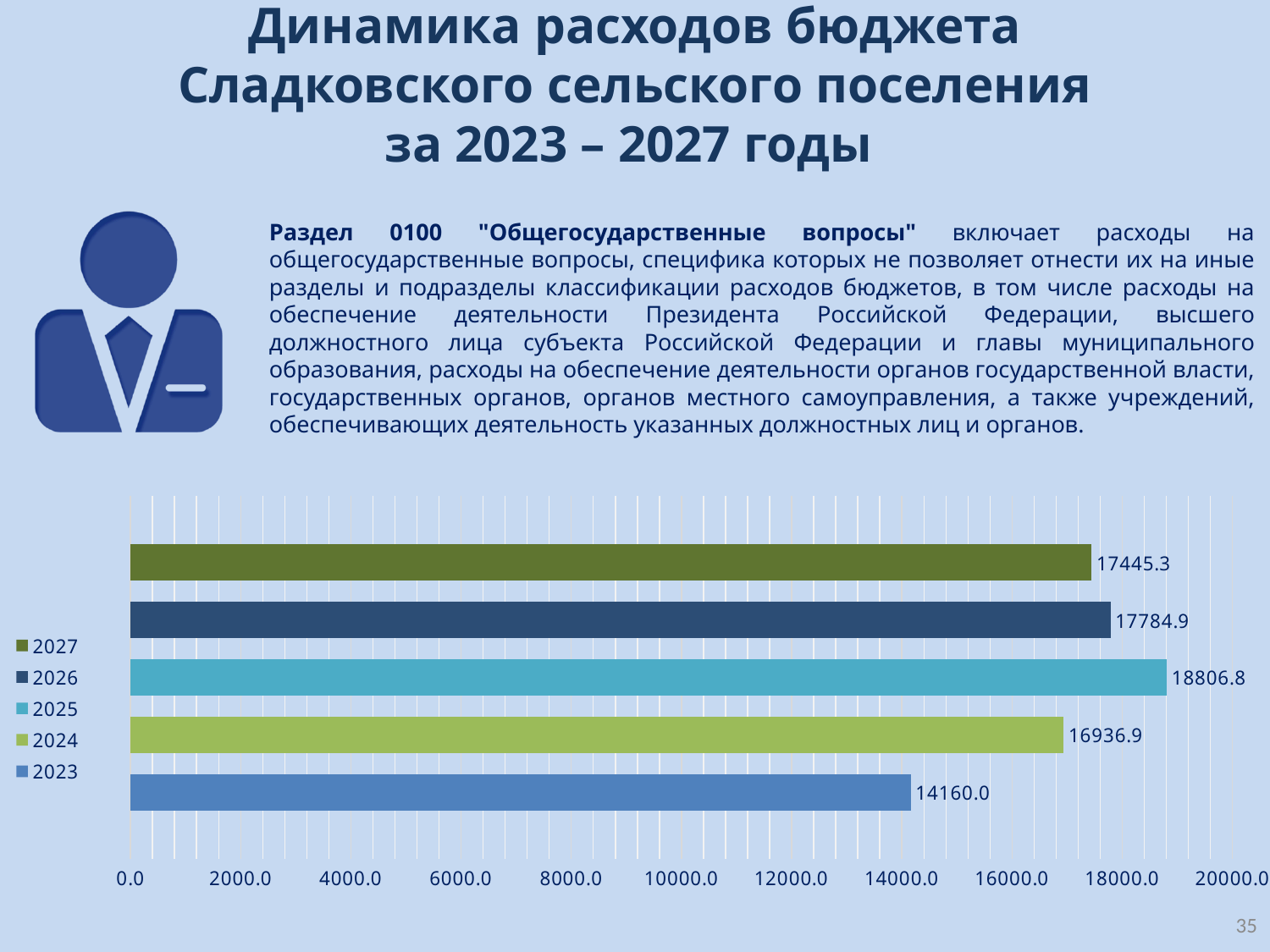
What is the value for 2023? 14160.0 What is the difference between the values for 2025 and 2023? 4646.8 Which year has the lowest value? 2023 Is the value for 2024 greater or less than 16000.0? greater What is the value for 2025? 18806.8 How many series does the legend list? 5 Which is larger, the value for 2024 or the value for 2026? 2026 Which year has the highest value? 2025 What is the difference between the values for 2026 and 2027? 339.6 What is the value for 2027? 17445.3 Do the values rise or fall from 2023 to 2025? rise What kind of chart is shown on the slide? bar chart